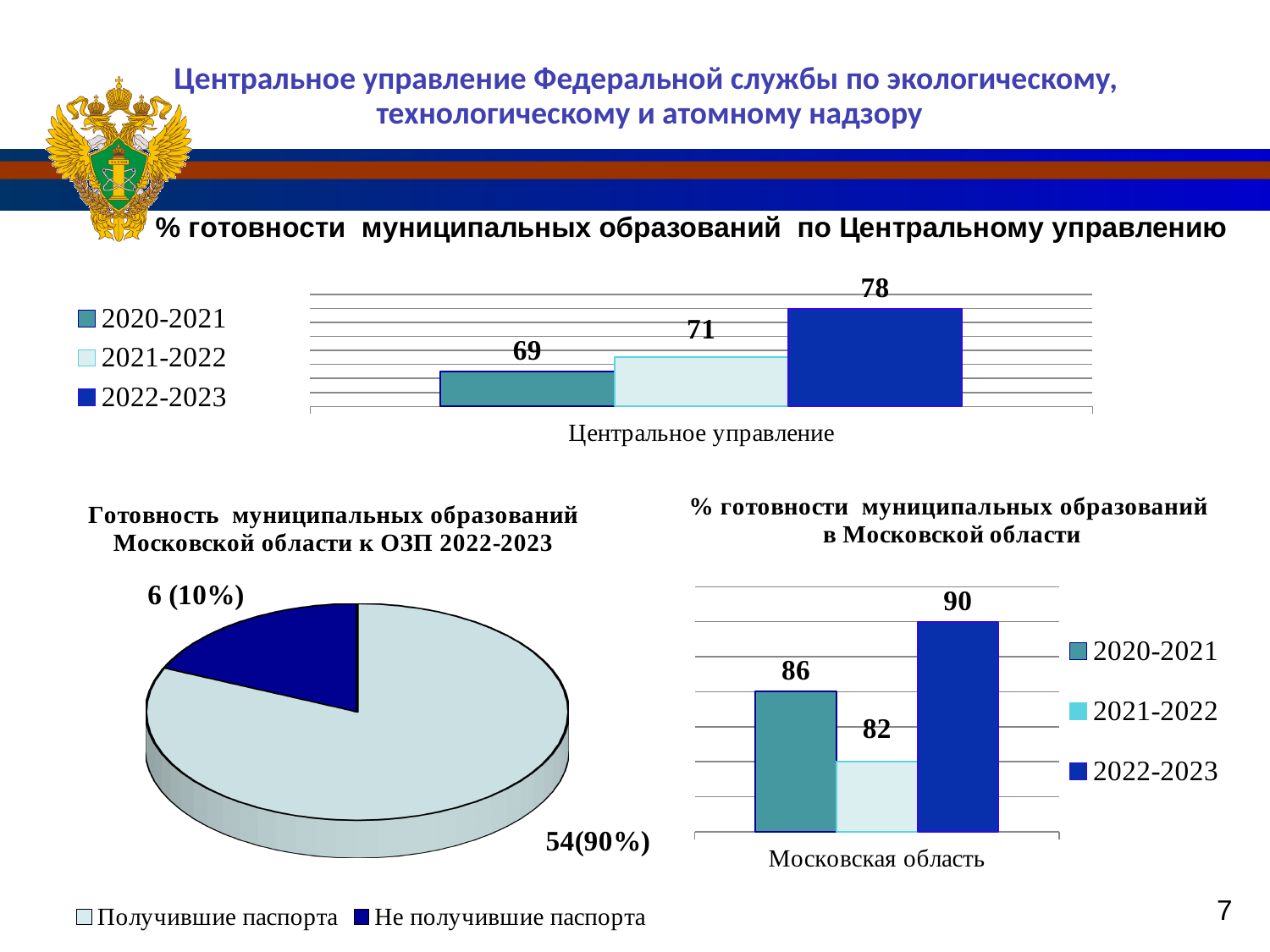
In the top chart '% готовности муниципальных образований по Центральному управлению', what is the value for 2022-2023? 78 In the top chart '% готовности муниципальных образований по Центральному управлению', what is the difference between the 2022-2023 and 2020-2021 values? 9 How many series does the legend of the top chart '% готовности муниципальных образований по Центральному управлению' list? 3 In the bottom-right chart '% готовности муниципальных образований в Московской области', which series has the lowest value? 2021-2022 In the bottom-right chart '% готовности муниципальных образований в Московской области', what is the difference between the 2022-2023 and 2021-2022 values? 8 In the top chart '% готовности муниципальных образований по Центральному управлению', what is the value for 2020-2021? 69 In the top chart '% готовности муниципальных образований по Центральному управлению', do the values rise or fall from 2020-2021 to 2022-2023? rise What kind of chart is the bottom-left chart 'Готовность муниципальных образований Московской области к ОЗП 2022-2023'? pie chart In the bottom-right chart '% готовности муниципальных образований в Московской области', what is the value for 2021-2022? 82 In the top chart '% готовности муниципальных образований по Центральному управлению', which series has the highest value? 2022-2023 In the bottom-left pie chart 'Готовность муниципальных образований Московской области к ОЗП 2022-2023', what share of the pie is 'Не получившие паспорта'? 10% In the bottom-right chart '% готовности муниципальных образований в Московской области', which is larger: the value for 2020-2021 or for 2022-2023? 2022-2023